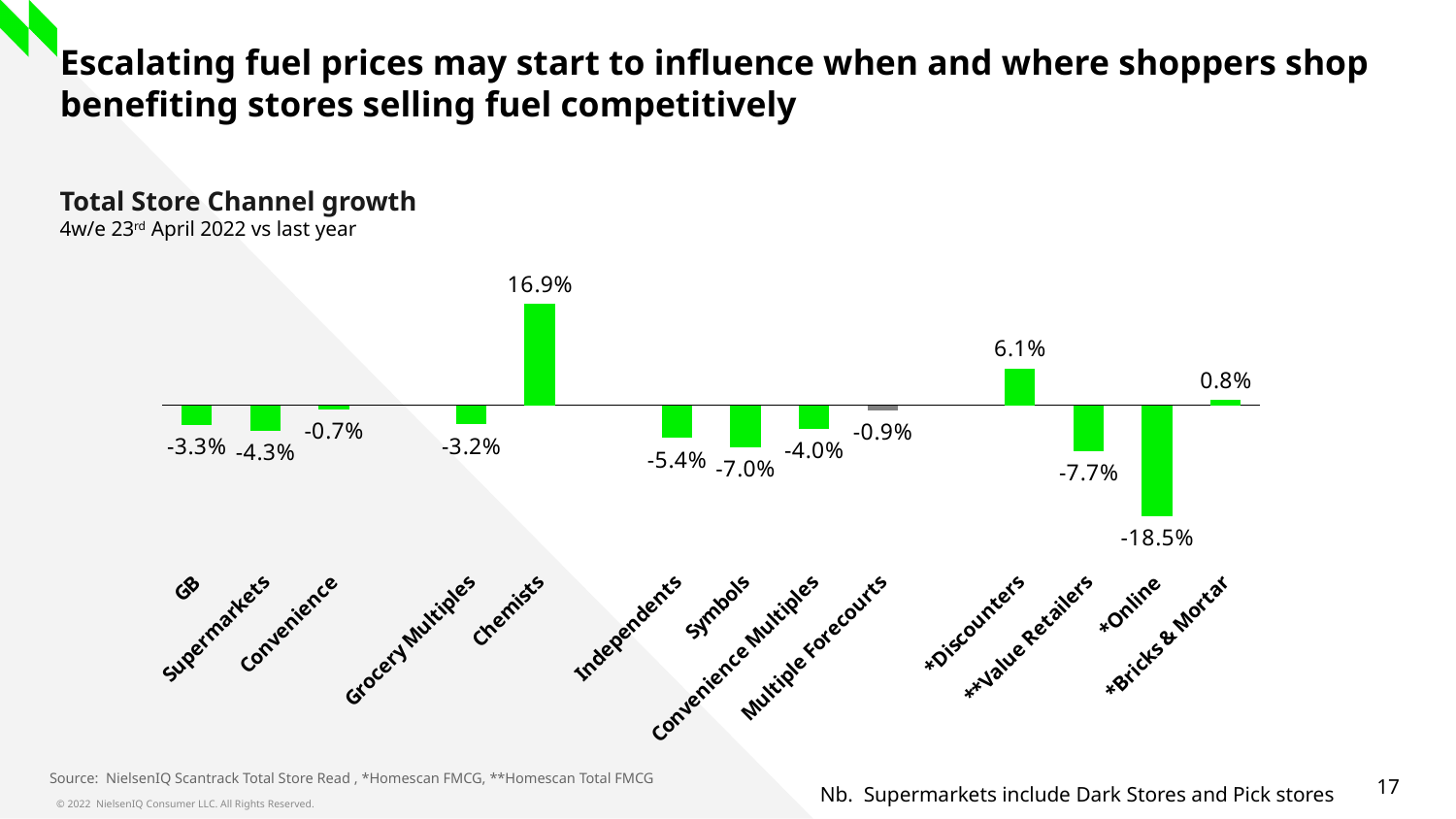
Which channel has the highest growth value? Chemists What is the growth value shown for Online? -18.5% Which channel has the lowest growth value? Online What is the value for Chemists in the Total Store Channel growth chart? 16.9% What is the value for Discounters? 6.1% Which has the larger value, Symbols or Independents? Independents What is the value shown for Multiple Forecourts? -0.9% What type of chart is used to show Total Store Channel growth? Bar chart What is the difference between the values for Chemists and Discounters? 10.8% What is the difference between the values for GB and Supermarkets? 1.0% Which bar in the chart is coloured grey rather than green? Multiple Forecourts How many channels are shown in the chart? 13